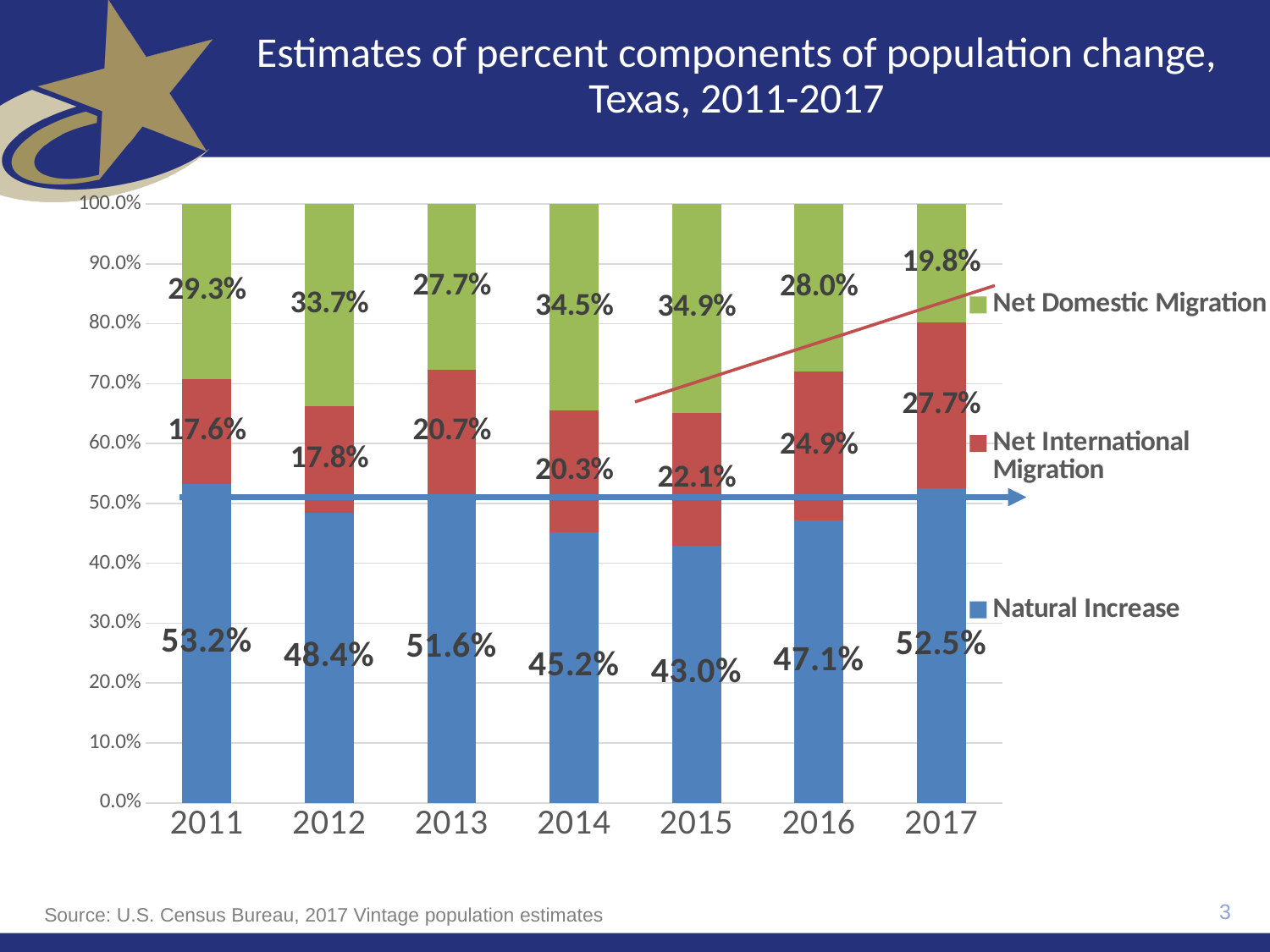
How many years are shown on the x axis? 7 In which year is Natural Increase highest? 2011 How many series does the legend list? 3 What is the Net Domestic Migration value for 2014? 34.5% What is the difference between the Net International Migration values for 2017 and 2011? 10.1% What kind of chart is shown on the slide? Stacked bar chart What is the Net International Migration value for 2017? 27.7% What is the Natural Increase value for 2015? 43.0% Which is larger in 2016: Natural Increase or Net Domestic Migration? Natural Increase Does Net International Migration rise or fall from 2011 to 2017? Rise Which series is shown in green? Net Domestic Migration In which year is Net Domestic Migration lowest? 2017